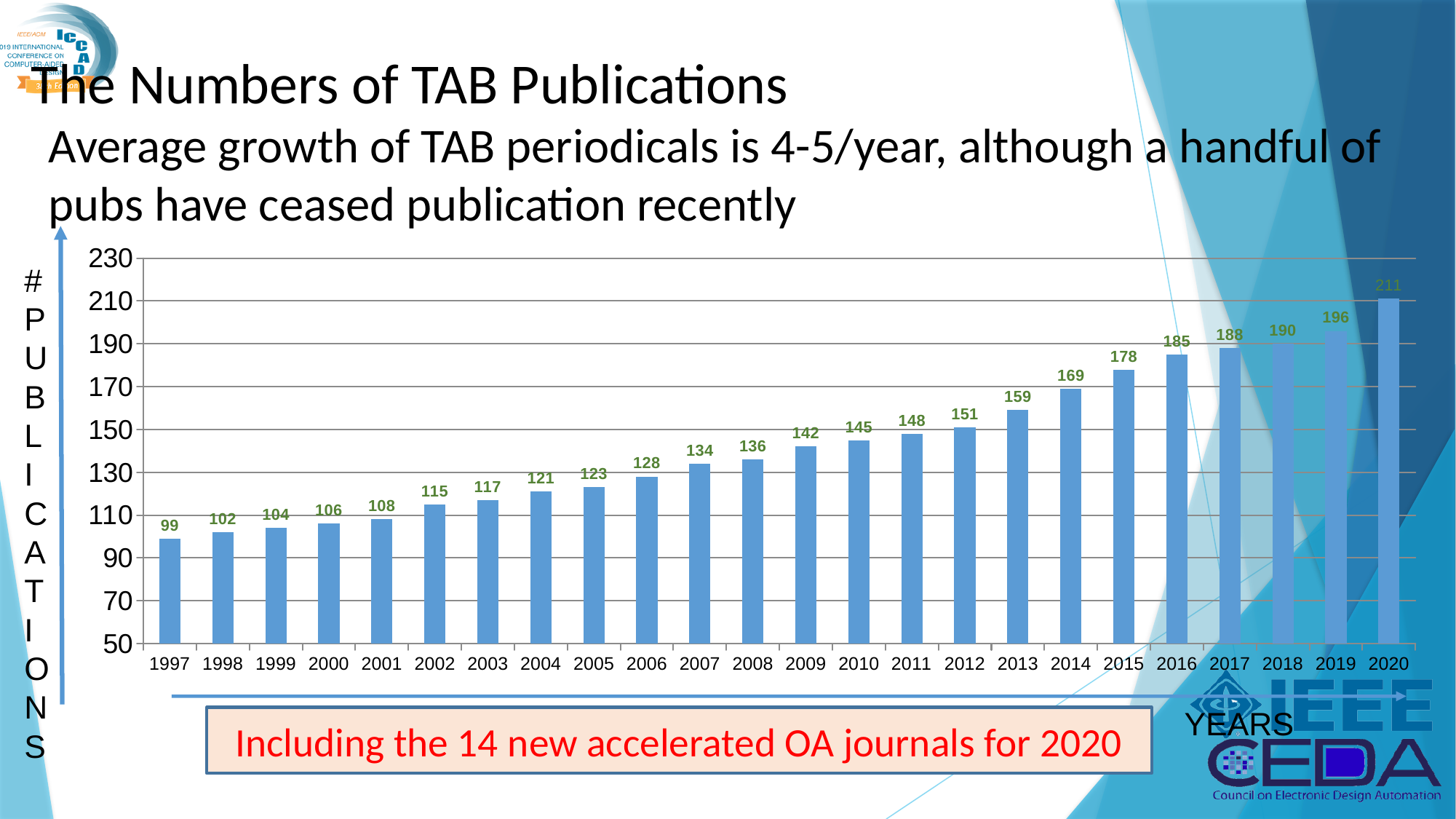
What is the difference between the number of publications in 2020 and in 1997? 112 What is the number of TAB publications in 2005? 123 Is the value for 2009 greater or less than 150? less What kind of chart is shown on the slide? bar chart What is the number of TAB publications in 2013? 159 What is the number of TAB publications in 2020? 211 Which year has more publications, 2008 or 2011? 2011 Do the values rise or fall from 1997 to 2020? rise What is the difference between the number of publications in 2015 and in 2014? 9 Which year has the highest number of TAB publications? 2020 Which year has the lowest number of TAB publications? 1997 How many years are shown on the x axis of the chart? 24